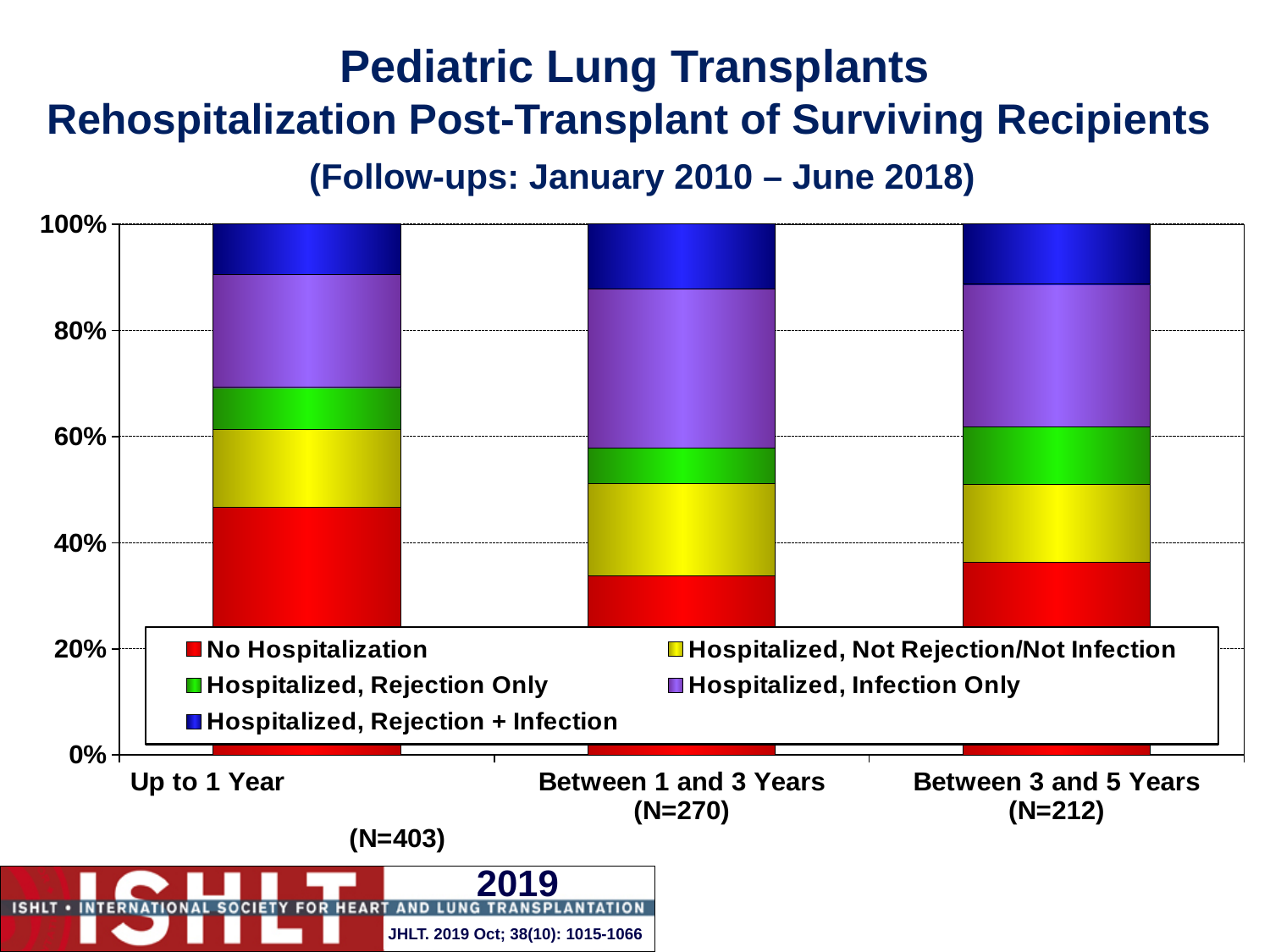
Is the No Hospitalization share for Between 1 and 3 Years greater or less than 40%? less What kind of chart is shown on the slide? Stacked bar chart What is the N for the Between 1 and 3 Years category? N=270 What is the total of the stacked bar for Between 3 and 5 Years? 100% Which time period has the smallest Hospitalized, Infection Only share? Up to 1 Year Is the No Hospitalization share for Up to 1 Year greater or less than 40%? greater Which time period has the largest No Hospitalization share? Up to 1 Year Which has the larger No Hospitalization share: Up to 1 Year or Between 1 and 3 Years? Up to 1 Year What follow-up period does the chart subtitle give? January 2010 – June 2018 How many series does the legend list? 5 How many time-period categories are shown on the x axis? 3